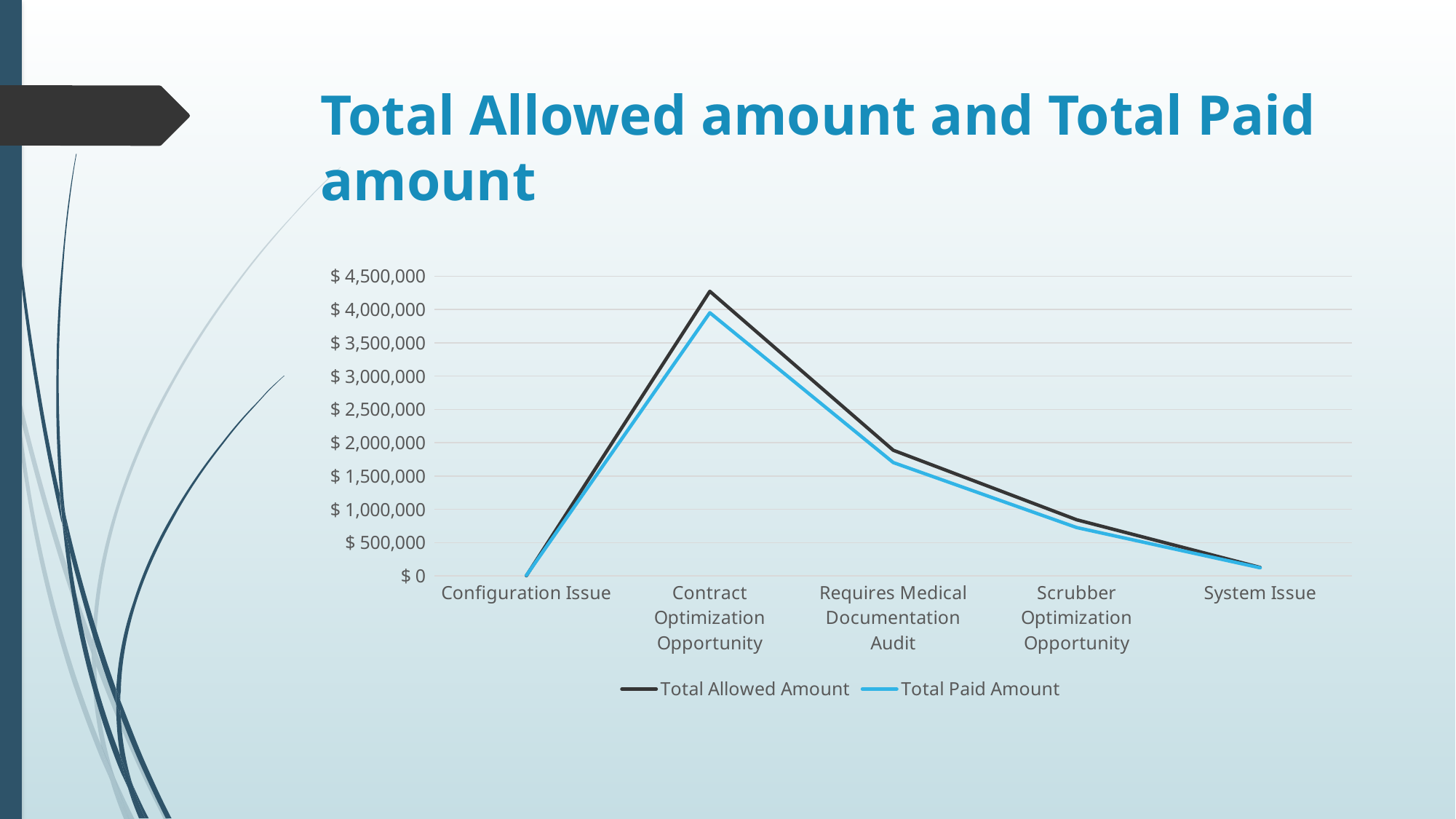
Is the Total Allowed Amount for Scrubber Optimization Opportunity greater or less than $ 1,000,000? less Which category has the lowest Total Paid Amount? Configuration Issue What colour is the Total Paid Amount line? light blue Which category has a larger Total Paid Amount, Requires Medical Documentation Audit or System Issue? Requires Medical Documentation Audit What kind of chart is shown on the slide? line chart How many categories are plotted along the x axis? 5 Is the Total Allowed Amount for Contract Optimization Opportunity greater or less than $ 4,000,000? greater How many series does the legend list? 2 Is the Total Paid Amount for Requires Medical Documentation Audit greater or less than $ 2,000,000? less Which is larger for Contract Optimization Opportunity, the Total Allowed Amount or the Total Paid Amount? Total Allowed Amount Which category has the highest Total Allowed Amount? Contract Optimization Opportunity Do the values rise or fall from Contract Optimization Opportunity to System Issue? fall